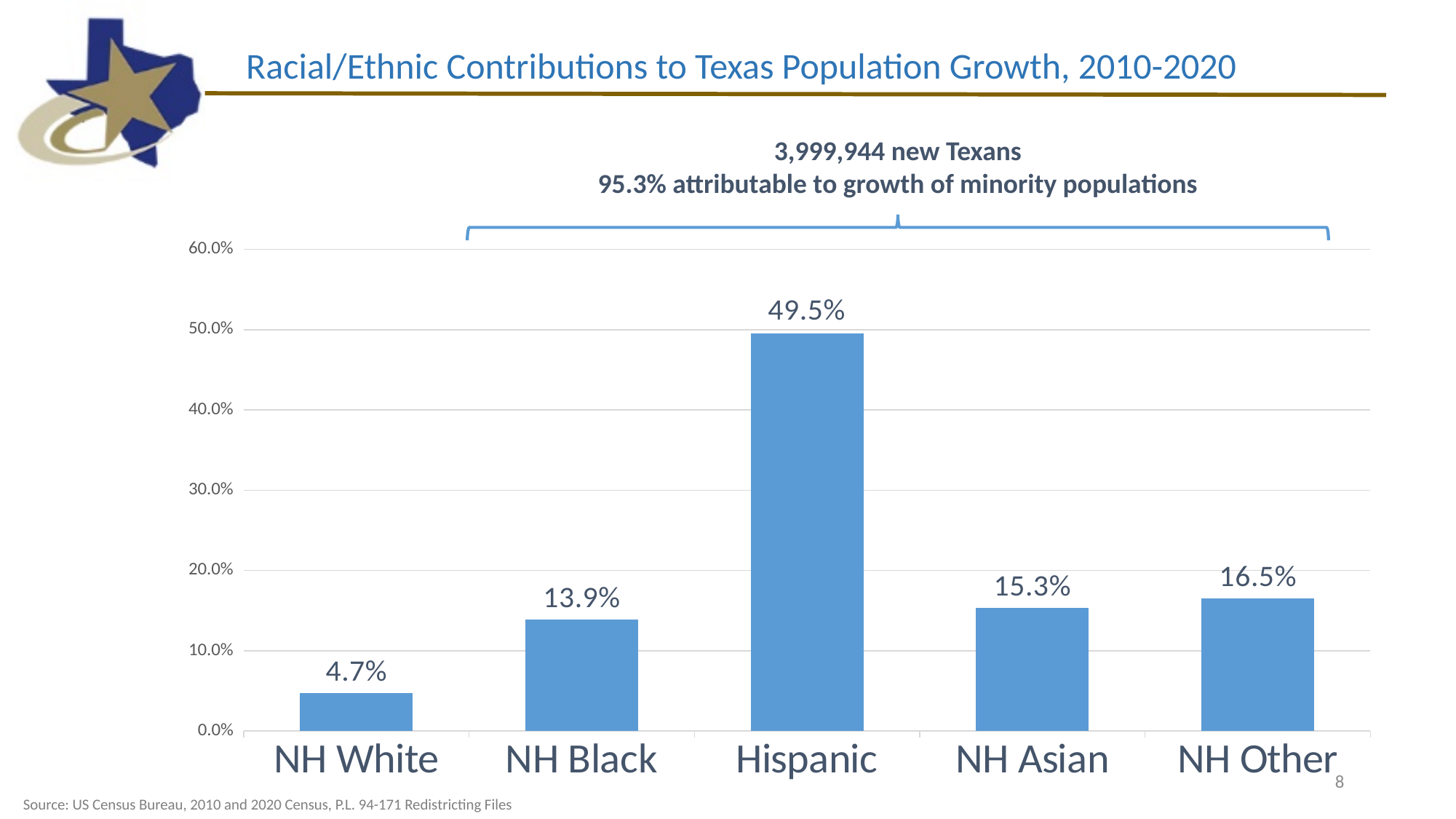
Which category has the highest value? Hispanic What is the difference between the values for Hispanic and NH Black? 35.6% Is the value for Hispanic greater or less than 40.0%? greater Which category has the lowest value? NH White How many categories are shown on the x axis? 5 What is the value for NH Asian? 15.3% What kind of chart is shown on the slide? bar chart Which is larger, the value for NH Black or the value for NH Asian? NH Asian What is the value for Hispanic? 49.5% What is the difference between the values for NH Other and NH White? 11.8% What is the title of the chart? Racial/Ethnic Contributions to Texas Population Growth, 2010-2020 What is the value for NH White? 4.7%